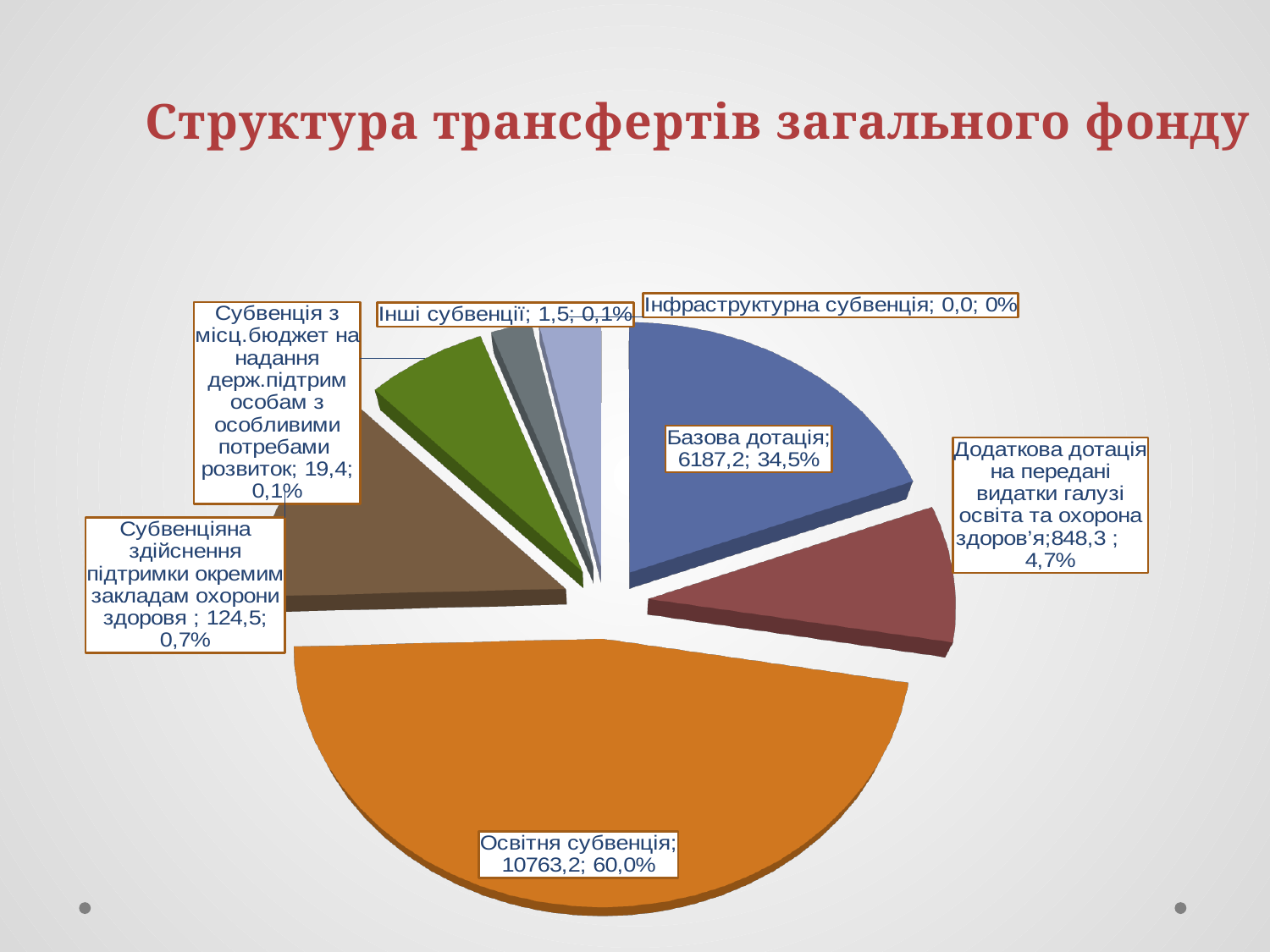
What is the value shown for Базова дотація? 6187,2 Which category has the smallest value? Інфраструктурна субвенція What is the value shown for Освітня субвенція? 10763,2 Which category has the largest value? Освітня субвенція What share of the pie does Освітня субвенція represent? 60,0% What is the difference between the values for Освітня субвенція and Базова дотація? 4576,0 What is the value shown for Інші субвенції? 1,5 What is the title of the chart? Структура трансфертів загального фонду What kind of chart is shown on the slide? pie chart Which is larger: the value for Базова дотація or the value for Додаткова дотація на передані видатки галузі освіта та охорона здоров'я? Базова дотація How many categories are labelled on the pie chart? 7 What share of the pie does Додаткова дотація на передані видатки галузі освіта та охорона здоров'я represent? 4,7%